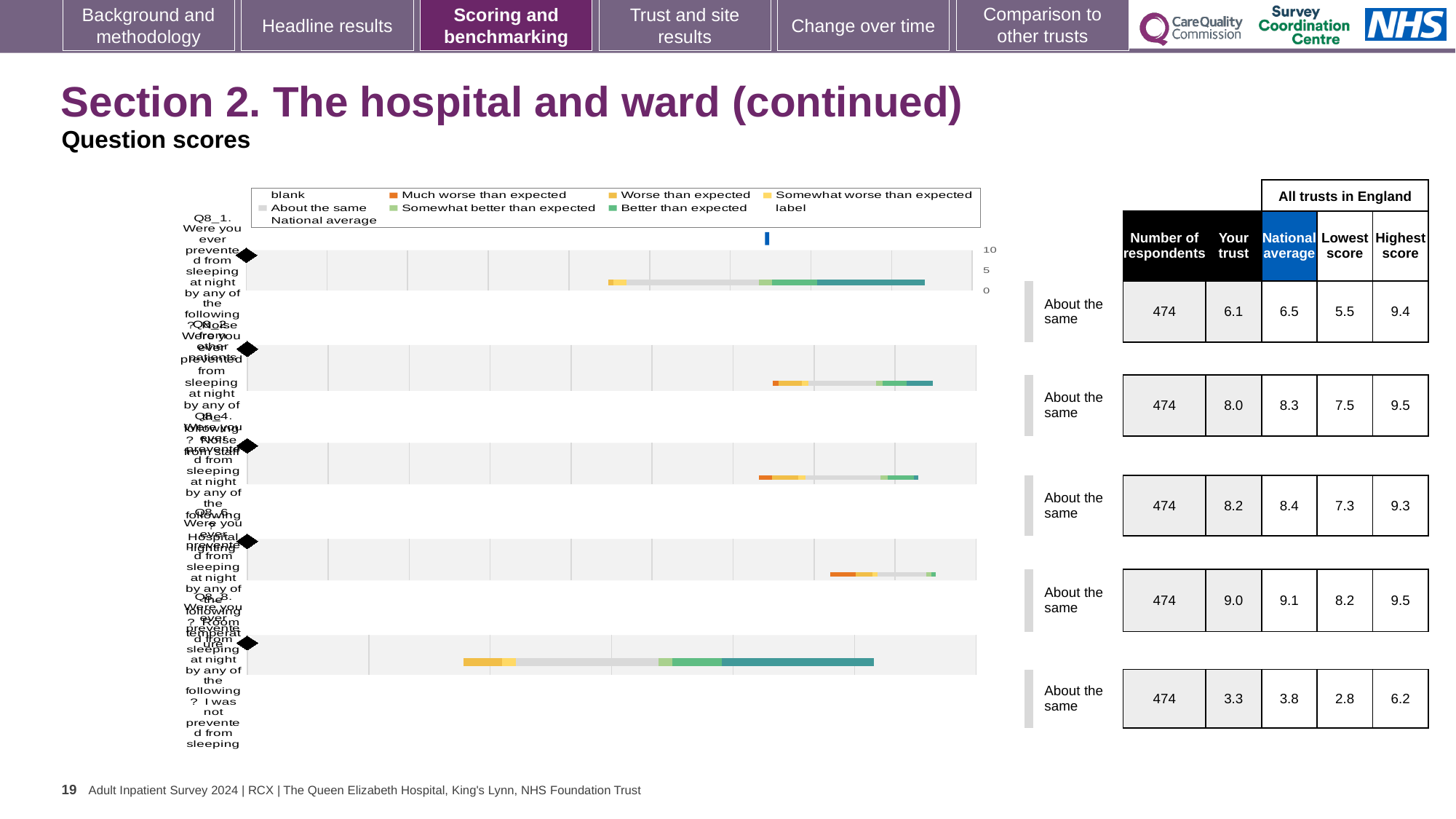
What is the 'Your trust' score for the last question row? 3.3 What kind of chart is shown on the slide? bar chart What is the national average for the first question row (Q8_1)? 6.5 What is the difference between the highest score and the lowest score for the last question row? 3.4 How many question rows are plotted in the chart? 5 Which legend entry is shown in dark orange? Much worse than expected What benchmark category is shown next to every question row in the chart? About the same Which question row has the lowest 'Your trust' score? the last row (3.3) What is the number of respondents for the last question row? 474 Which question row has the highest 'Your trust' score? the fourth row (9.0) What is the 'Your trust' score for the first question row (Q8_1)? 6.1 How many entries does the chart legend list? 9